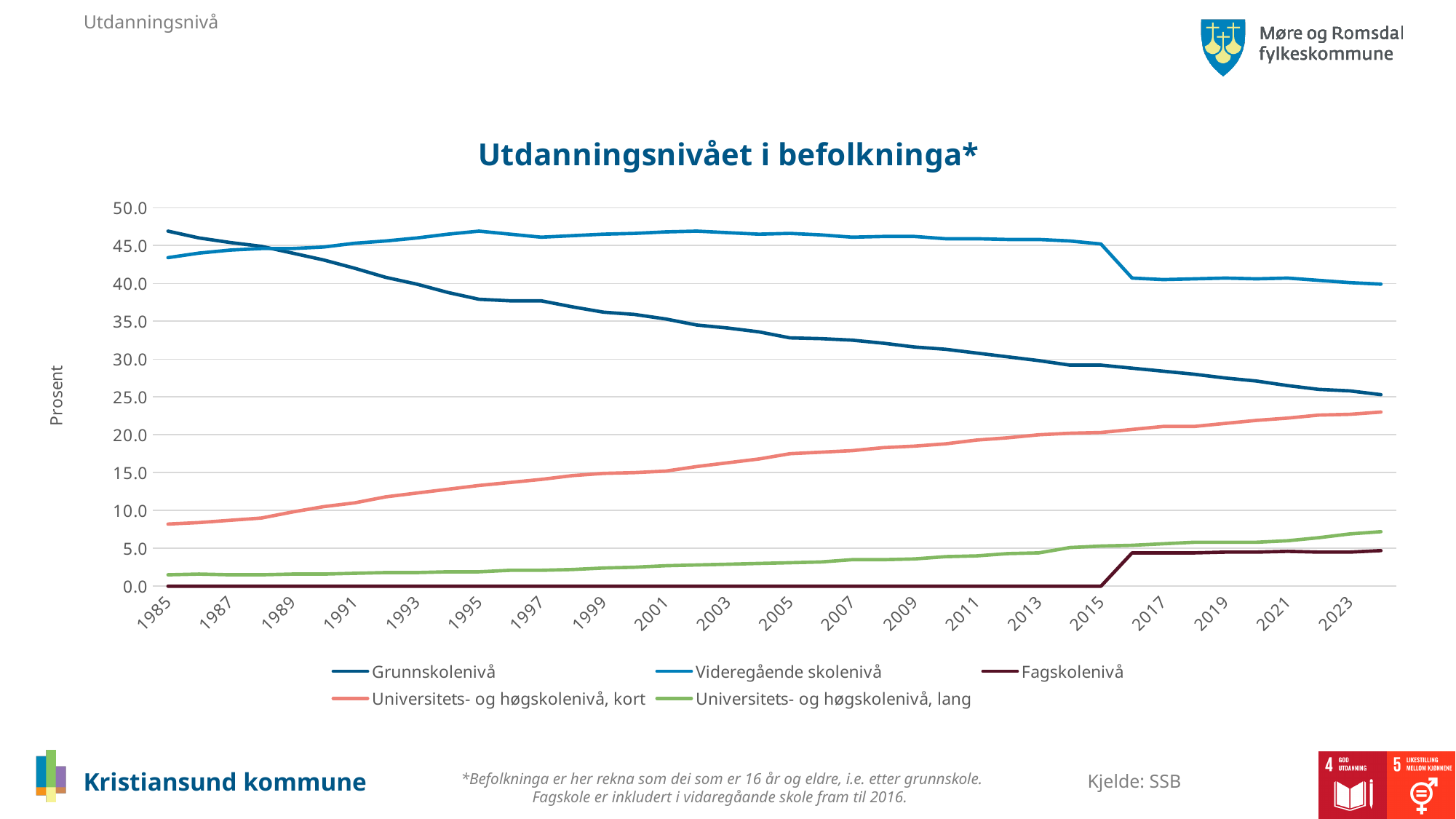
Does the value for Grunnskolenivå rise or fall from 1985 to 2023? Fall How many series does the legend list? 5 Does the value for Universitets- og høgskolenivå, kort rise or fall from 1985 to 2023? Rise Is the value for Universitets- og høgskolenivå, kort in 2023 greater or less than 20.0? greater What is the label on the y axis? Prosent Is the value for Grunnskolenivå in 1985 greater or less than 45.0? greater Which series has the lowest value in 1985? Fagskolenivå Which series has the highest value in 2023? Videregående skolenivå What kind of chart is shown on the slide? Line chart What is the title of the chart? Utdanningsnivået i befolkninga* In 1985, which is larger: Grunnskolenivå or Videregående skolenivå? Grunnskolenivå What is the value for Fagskolenivå in 2011? 0.0